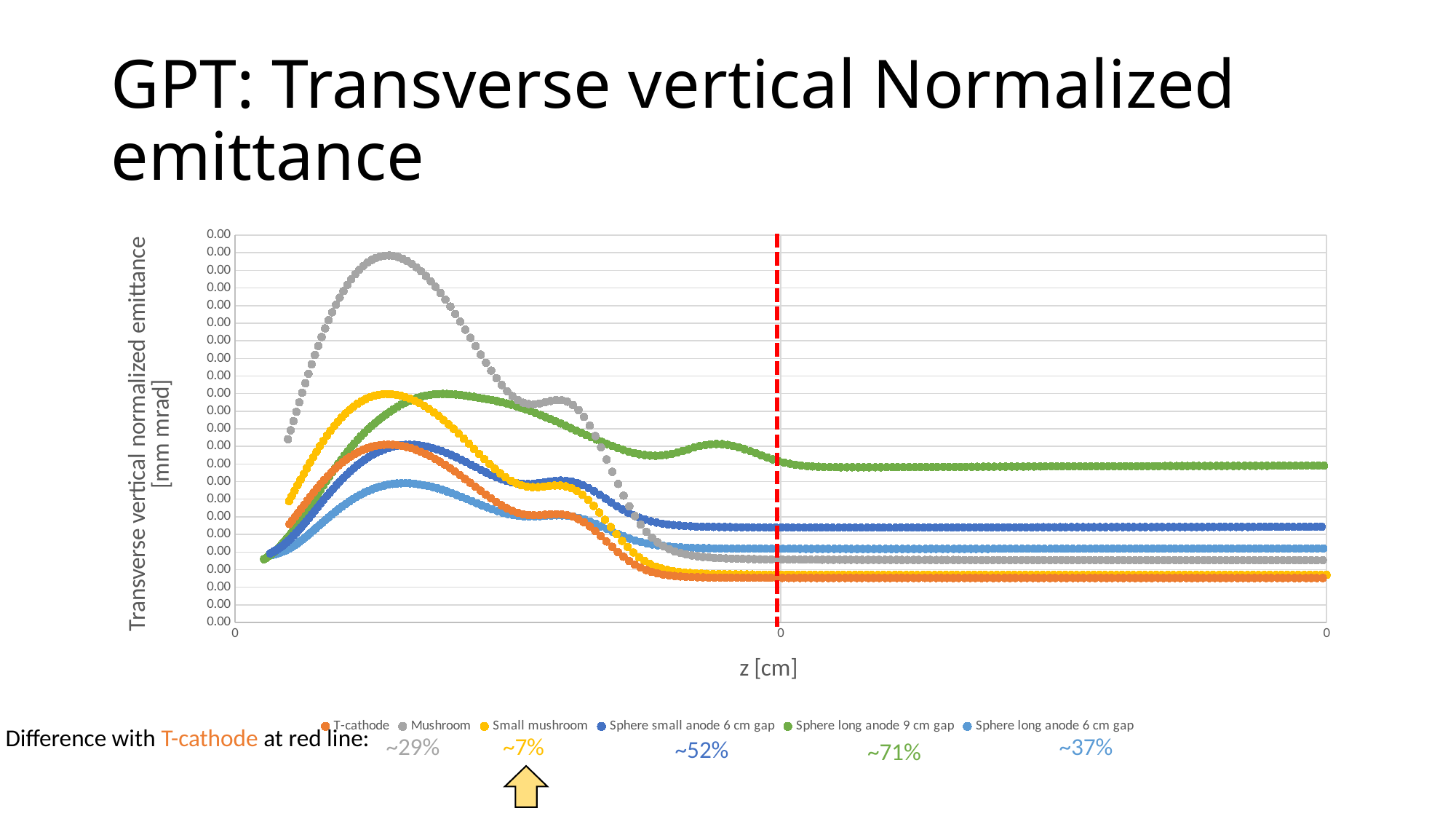
How many series does the chart legend list? 6 What kind of chart is shown on the slide? scatter chart What is the title of the x axis? z [cm] Which series has the highest value at the far right end of the chart? Sphere long anode 9 cm gap At the right end of the chart, which is higher: Sphere small anode 6 cm gap or Sphere long anode 6 cm gap? Sphere small anode 6 cm gap Which series reaches the highest peak value on the chart? Mushroom How does the Mushroom series behave along the x axis before it flattens out? rises then falls Which series has the lowest peak value on the chart? Sphere long anode 6 cm gap At the right end of the chart, does the Mushroom series sit above or below the Sphere long anode 6 cm gap series? below What is the title of the y axis? Transverse vertical normalized emittance [mm mrad] Which series has the higher peak: Small mushroom or T-cathode? Small mushroom